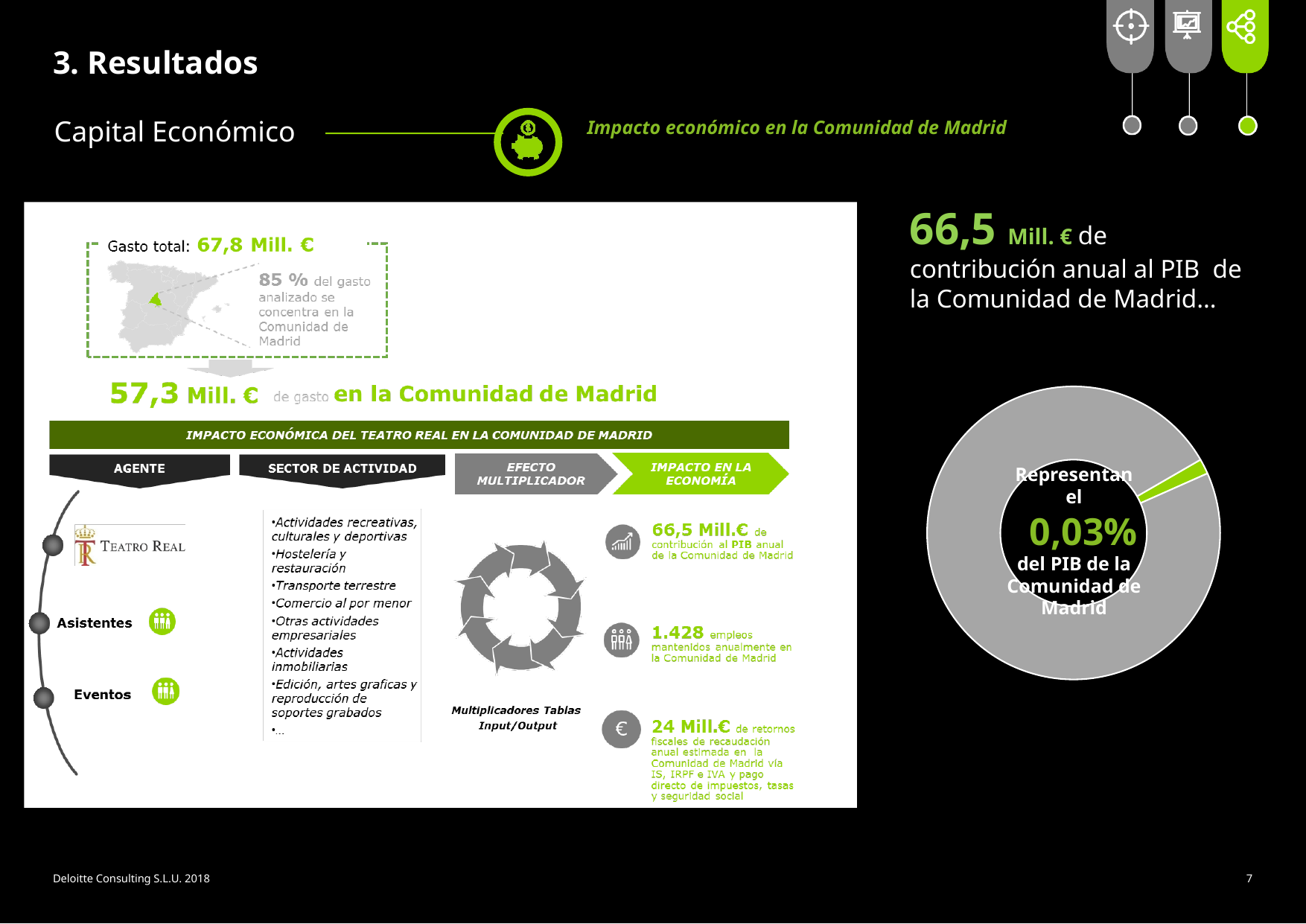
Does the donut chart on the right have a legend? No What kind of chart is shown on the right side of the slide? Donut (pie) chart According to the label in the centre of the donut chart, what percentage of the PIB of the Comunidad de Madrid does the highlighted slice represent? 0,03% How many slices does the donut chart on the right contain? 2 What text is written in the centre of the donut chart? Representan el 0,03% del PIB de la Comunidad de Madrid In the donut chart on the right, which slice is larger, the grey one or the green one? The grey one Is the share of the green slice in the donut chart greater or less than 50%? less What colour is the small highlighted slice in the donut chart? Green